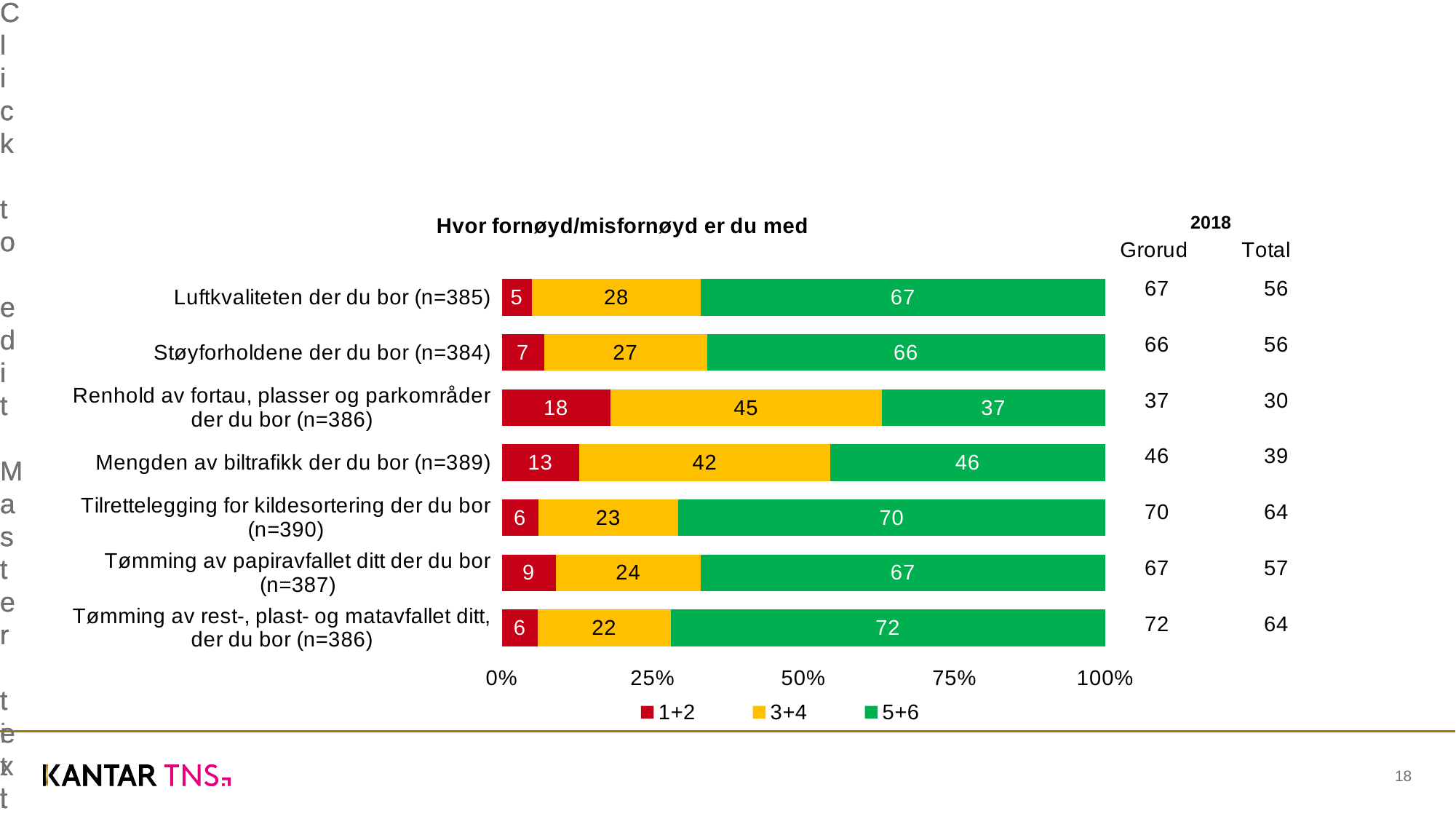
What is the 5+6 value for Luftkvaliteten der du bor (n=385)? 67 What is the 1+2 value for Renhold av fortau, plasser og parkområder der du bor (n=386)? 18 Which is larger: the 3+4 value for Renhold av fortau, plasser og parkområder der du bor (n=386) or the 3+4 value for Mengden av biltrafikk der du bor (n=389)? Renhold av fortau, plasser og parkområder der du bor (n=386) What is the title of the chart? Hvor fornøyd/misfornøyd er du med What is the 3+4 value for Mengden av biltrafikk der du bor (n=389)? 42 Which category has the highest 5+6 value? Tømming av rest-, plast- og matavfallet ditt, der du bor (n=386) What kind of chart is shown on the slide? Stacked bar chart What is the difference between the 5+6 values for Tilrettelegging for kildesortering der du bor (n=390) and Støyforholdene der du bor (n=384)? 4 How many categories are shown in the chart? 7 How many series does the legend list? 3 Which category has the lowest 5+6 value? Renhold av fortau, plasser og parkområder der du bor (n=386) What is the total of the stacked bar for Tømming av papiravfallet ditt der du bor (n=387)? 100